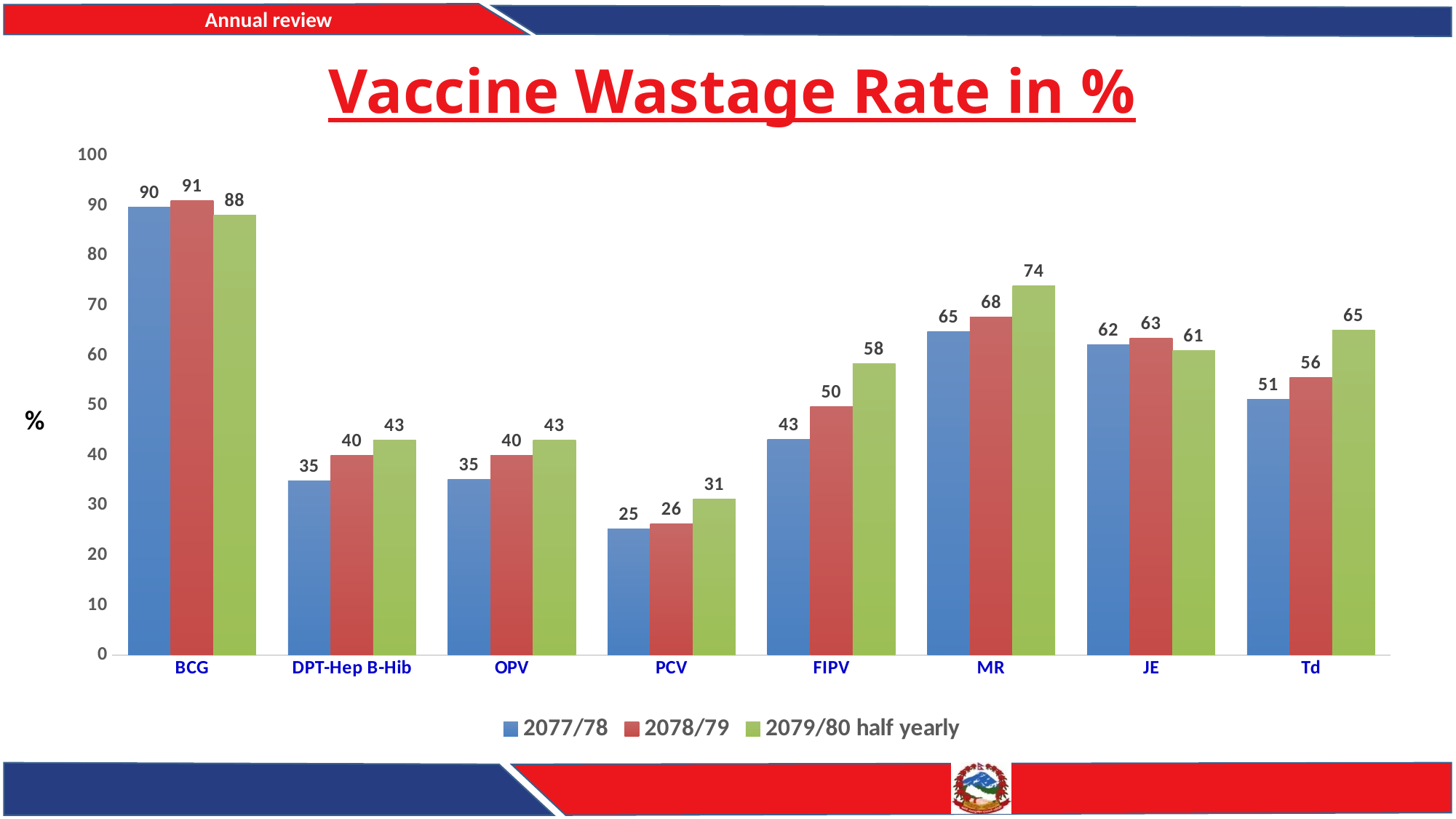
Which vaccine has the lowest wastage rate in 2079/80 half yearly? PCV Is the 2078/79 wastage rate for Td greater or less than 60? less Which vaccine has the highest wastage rate in 2077/78? BCG How many vaccines are shown on the x axis? 8 What is the vaccine wastage rate for PCV in 2077/78? 25 Which is larger for JE: the 2078/79 wastage rate or the 2079/80 half yearly wastage rate? 2078/79 What is the title of the chart? Vaccine Wastage Rate in % What is the difference between the 2079/80 half yearly and 2077/78 wastage rates for FIPV? 15 What is the vaccine wastage rate for MR in 2079/80 half yearly? 74 How many series does the legend list? 3 What is the vaccine wastage rate for BCG in 2078/79? 91 What kind of chart is shown on the slide? bar chart